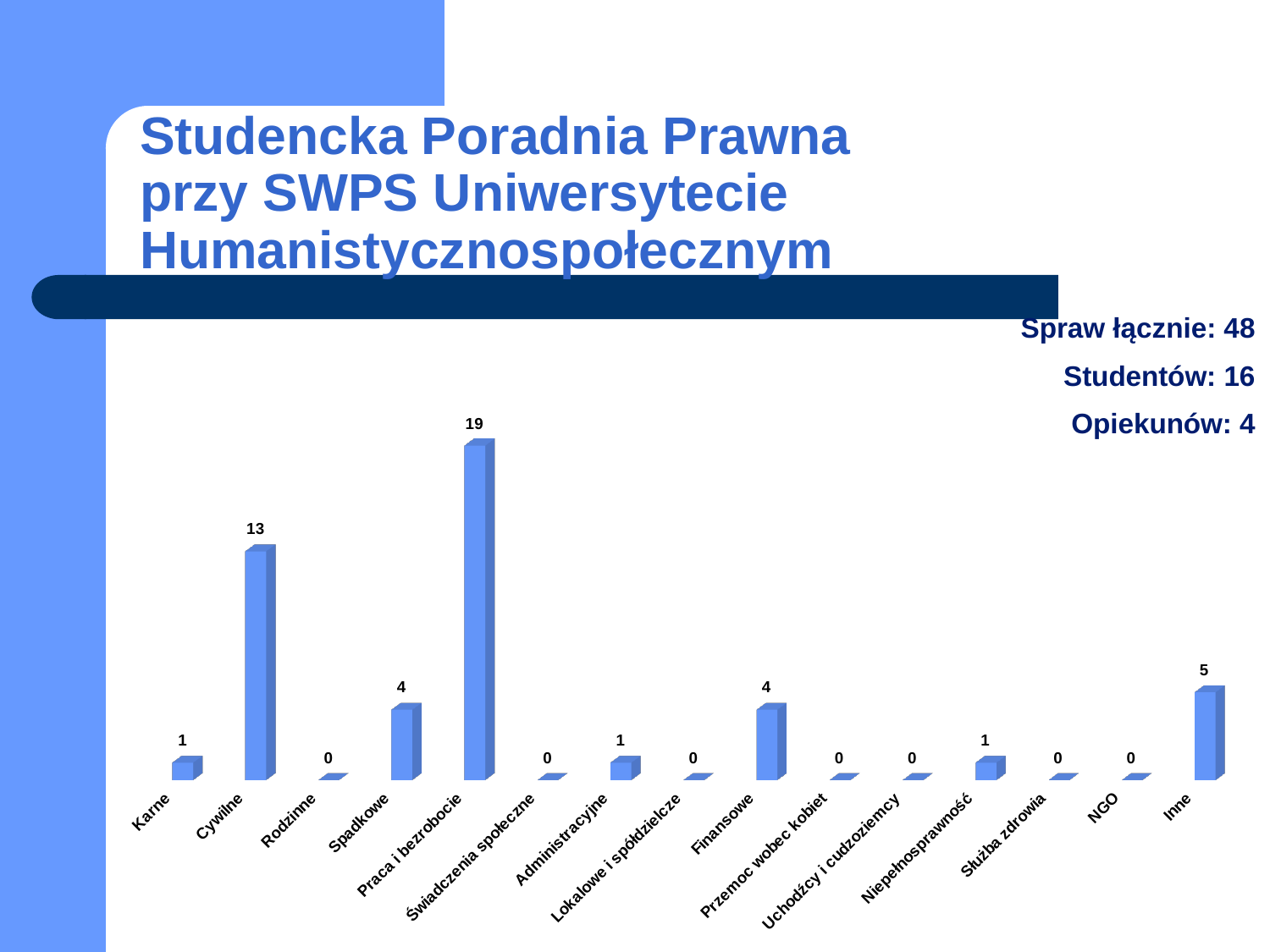
What kind of chart is shown on the slide? Bar chart What is the difference between the values for Inne and Spadkowe? 1 Which is larger, the value for Cywilne or the value for Inne? Cywilne Which category has the highest value? Praca i bezrobocie What is the value for Finansowe? 4 How many categories have a value of 0? 7 What is the difference between the values for Praca i bezrobocie and Cywilne? 6 What is the value for Niepełnosprawność? 1 What is the value for Cywilne? 13 What is the value for Praca i bezrobocie? 19 How many categories are shown on the x axis? 15 What is the value for Inne? 5